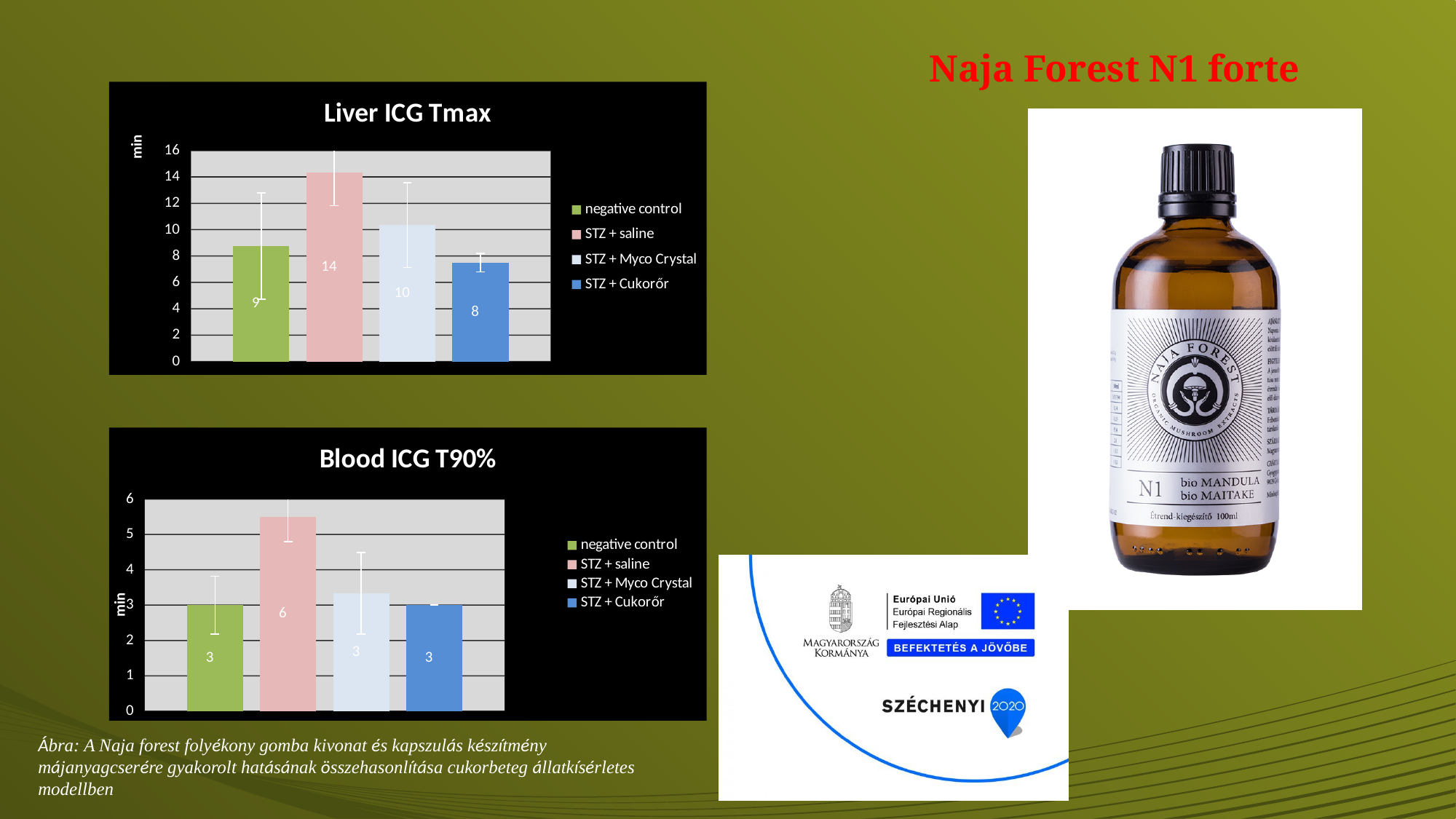
In the Liver ICG Tmax chart, which is larger, the value for STZ + saline or the value for STZ + Myco Crystal? STZ + saline What kind of chart is the Liver ICG Tmax chart? bar chart In the Liver ICG Tmax chart, which group has the highest value? STZ + saline How many bars are plotted in the Liver ICG Tmax chart? 4 How many series does the legend of the Blood ICG T90% chart list? 4 In the Liver ICG Tmax chart, what is the value for STZ + saline? 14 In the Liver ICG Tmax chart, what is the value for STZ + Cukorőr? 8 In the Blood ICG T90% chart, is the value for STZ + saline greater or less than 5? greater In the Liver ICG Tmax chart, which group has the lowest value? STZ + Cukorőr In the Blood ICG T90% chart, which group has the highest value? STZ + saline In the Liver ICG Tmax chart, what is the difference between the labelled values for STZ + saline and STZ + Cukorőr? 6 In the Blood ICG T90% chart, what is the value for STZ + saline? 6